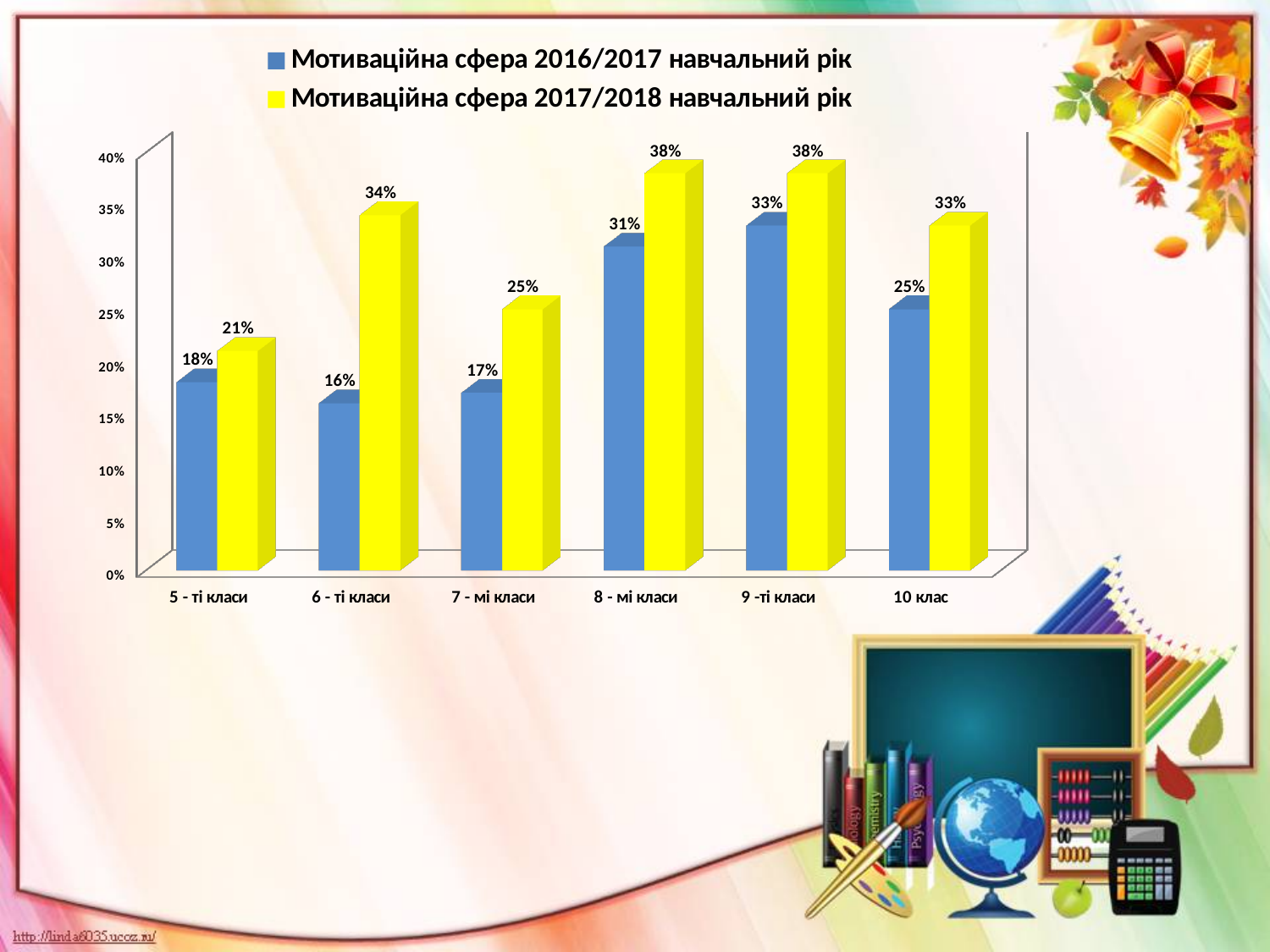
How many categories are shown on the x axis? 6 What is the difference between the 2017/2018 and 2016/2017 values for 6 - ті класи? 18% How many series does the legend list? 2 What kind of chart is shown on the slide? bar chart What is the value for 10 клас in the series Мотиваційна сфера 2017/2018 навчальний рік? 33% What is the value for 6 - ті класи in the series Мотиваційна сфера 2017/2018 навчальний рік? 34% What is the value for 8 - мі класи in the series Мотиваційна сфера 2016/2017 навчальний рік? 31% Which category has the highest value in the series Мотиваційна сфера 2016/2017 навчальний рік? 9 -ті класи Which category has the lowest value in the series Мотиваційна сфера 2016/2017 навчальний рік? 6 - ті класи Which is larger: the 2016/2017 value for 9 -ті класи or the 2016/2017 value for 10 клас? 9 -ті класи What is the difference between the 2017/2018 and 2016/2017 values for 7 - мі класи? 8% Which category has the lowest value in the series Мотиваційна сфера 2017/2018 навчальний рік? 5 - ті класи